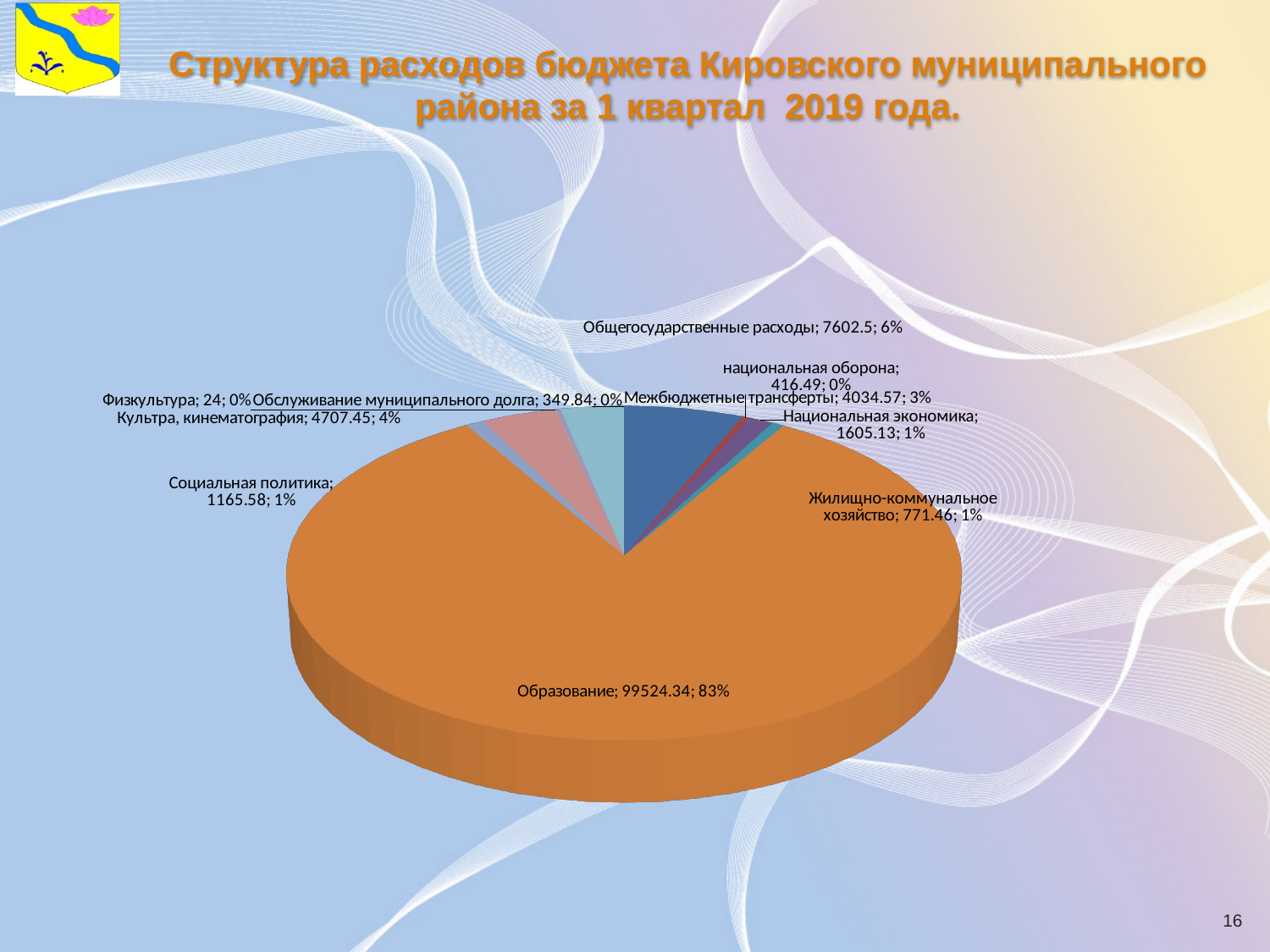
What is the value for Общегосударственные расходы? 7602.5 What share of the pie does Общегосударственные расходы represent? 6% Which is larger, Национальная экономика or Социальная политика? Национальная экономика What share of the pie does Образование represent? 83% What is the value for Межбюджетные трансферты? 4034.57 What is the difference between the values for Культра, кинематография and Межбюджетные трансферты? 672.88 What is the value for Культра, кинематография? 4707.45 Which category has the largest value? Образование How many categories are shown in the pie chart? 10 What is the value for Образование? 99524.34 What kind of chart is shown on the slide? pie chart Which category has the smallest value? Физкультура